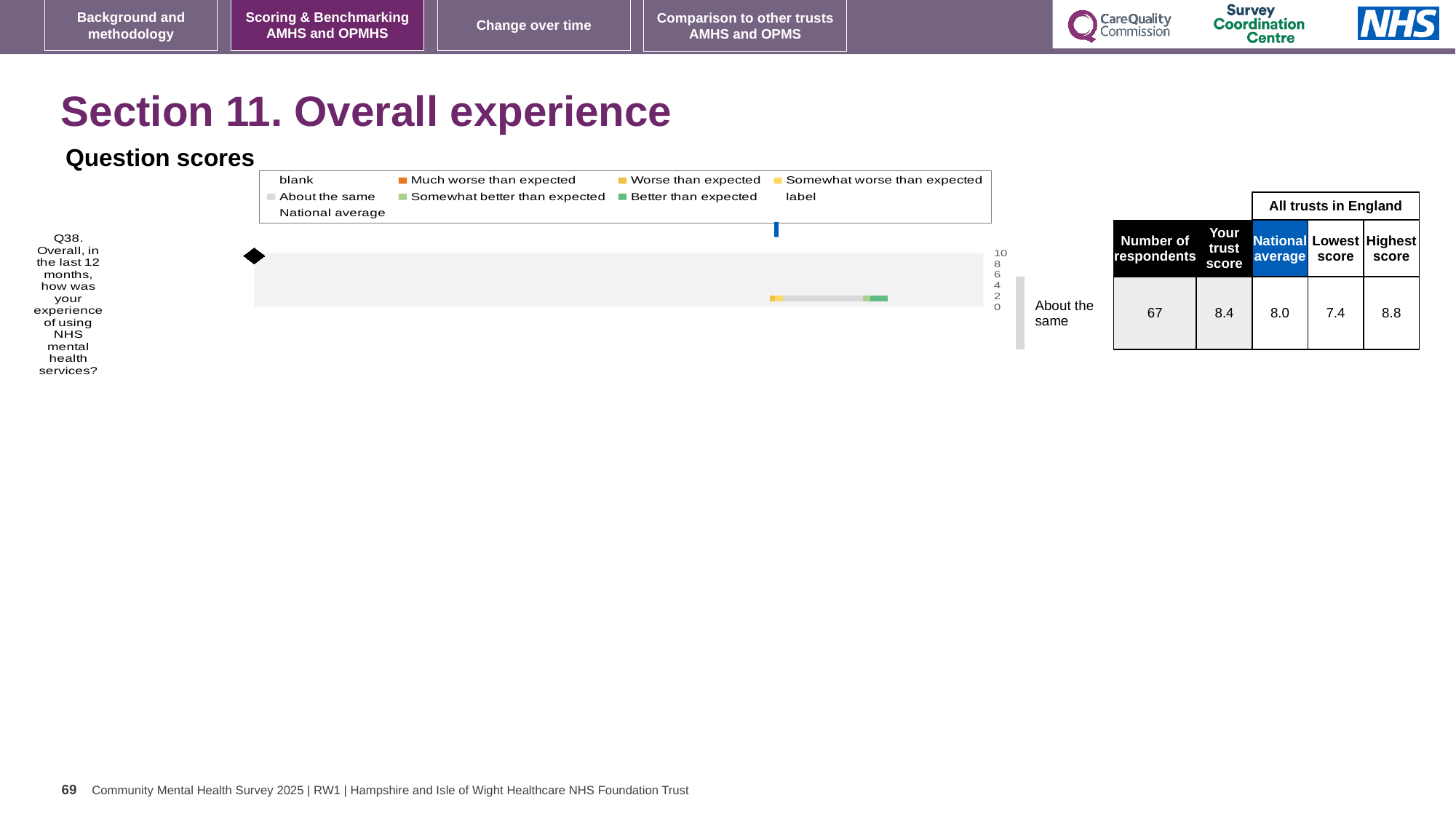
What is the difference between the highest and lowest scores among all trusts in England for Q38? 1.4 How many questions (categories) are plotted in the Question scores chart? 1 What kind of chart is shown under 'Question scores'? bar chart Which is larger for Q38, the trust score or the national average? trust score What is the trust score for Q38? 8.4 What is the lowest score among all trusts in England for Q38? 7.4 How many respondents answered Q38? 67 How is the trust's result for Q38 categorised relative to other trusts? About the same What is the national average score for Q38? 8.0 What is the highest score among all trusts in England for Q38? 8.8 What is the difference between the trust score and the national average for Q38? 0.4 Which question is plotted in the Question scores chart? Q38. Overall, in the last 12 months, how was your experience of using NHS mental health services?